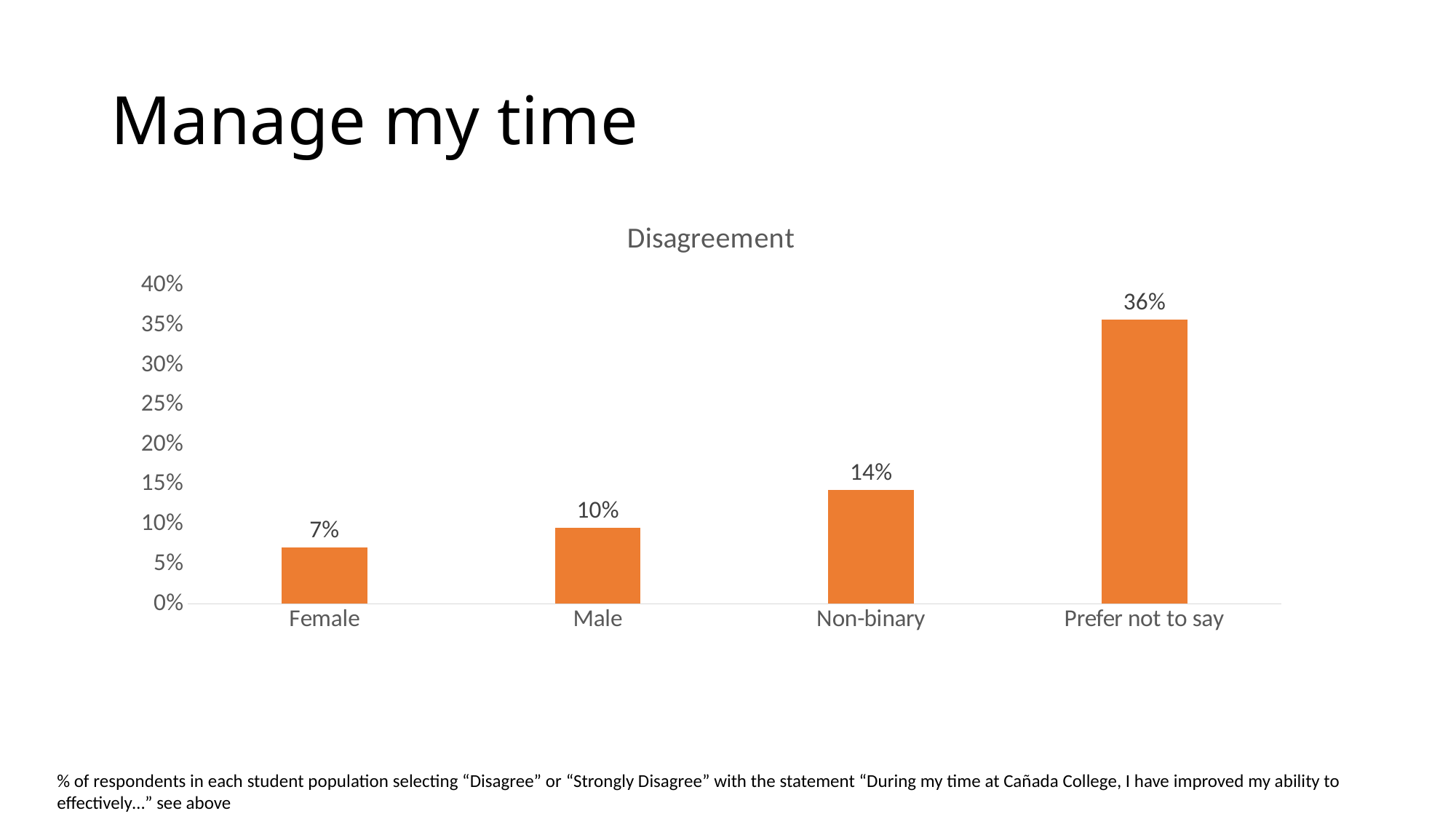
Which category has the highest value? Prefer not to say What kind of chart is shown? bar chart Which category has the lowest value? Female What is the difference between the values for Prefer not to say and Non-binary? 22% What is the value for Female? 7% Which is larger, the value for Male or the value for Non-binary? Non-binary Is the value for Prefer not to say greater or less than 30%? greater What is the title of the chart? Disagreement What is the value for Male? 10% How many categories are shown on the x axis? 4 What is the value for Prefer not to say? 36% What is the value for Non-binary? 14%